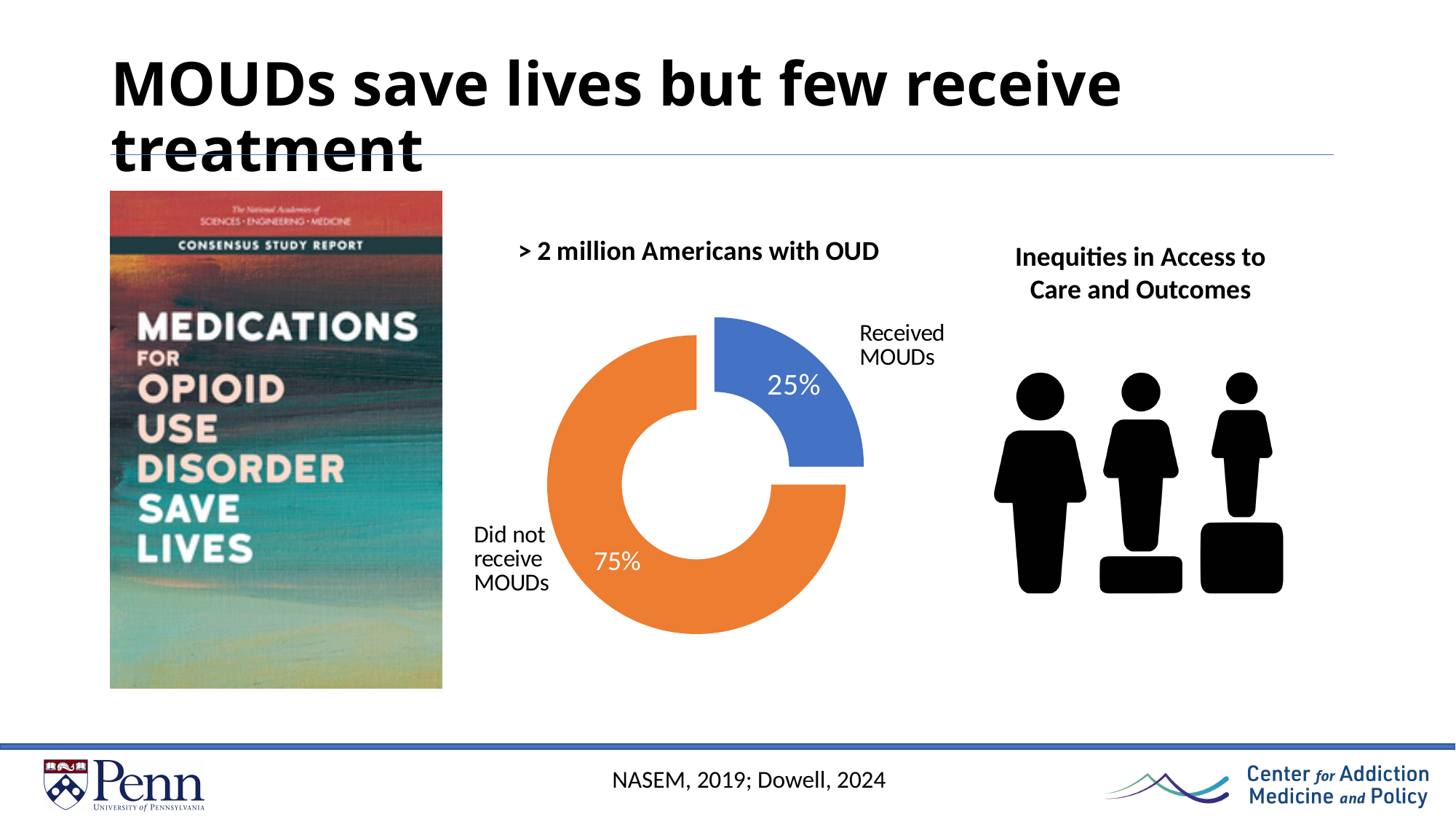
What kind of chart is used to show the share of Americans with OUD who received MOUDs? Donut (pie) chart What is the title above the donut chart? > 2 million Americans with OUD Which category in the donut chart has the largest share? Did not receive MOUDs What is the difference in percentage points between those who did not receive MOUDs and those who received MOUDs? 50 What percentage of Americans with OUD did not receive MOUDs according to the donut chart? 75% How many categories does the donut chart show? 2 Which category in the donut chart has the smallest share? Received MOUDs What colour is the 'Received MOUDs' slice in the donut chart? Blue What share of the donut chart does the 'Received MOUDs' slice represent? 25% What percentage of Americans with OUD received MOUDs according to the donut chart? 25% Which is larger in the donut chart: the share that received MOUDs or the share that did not receive MOUDs? Did not receive MOUDs